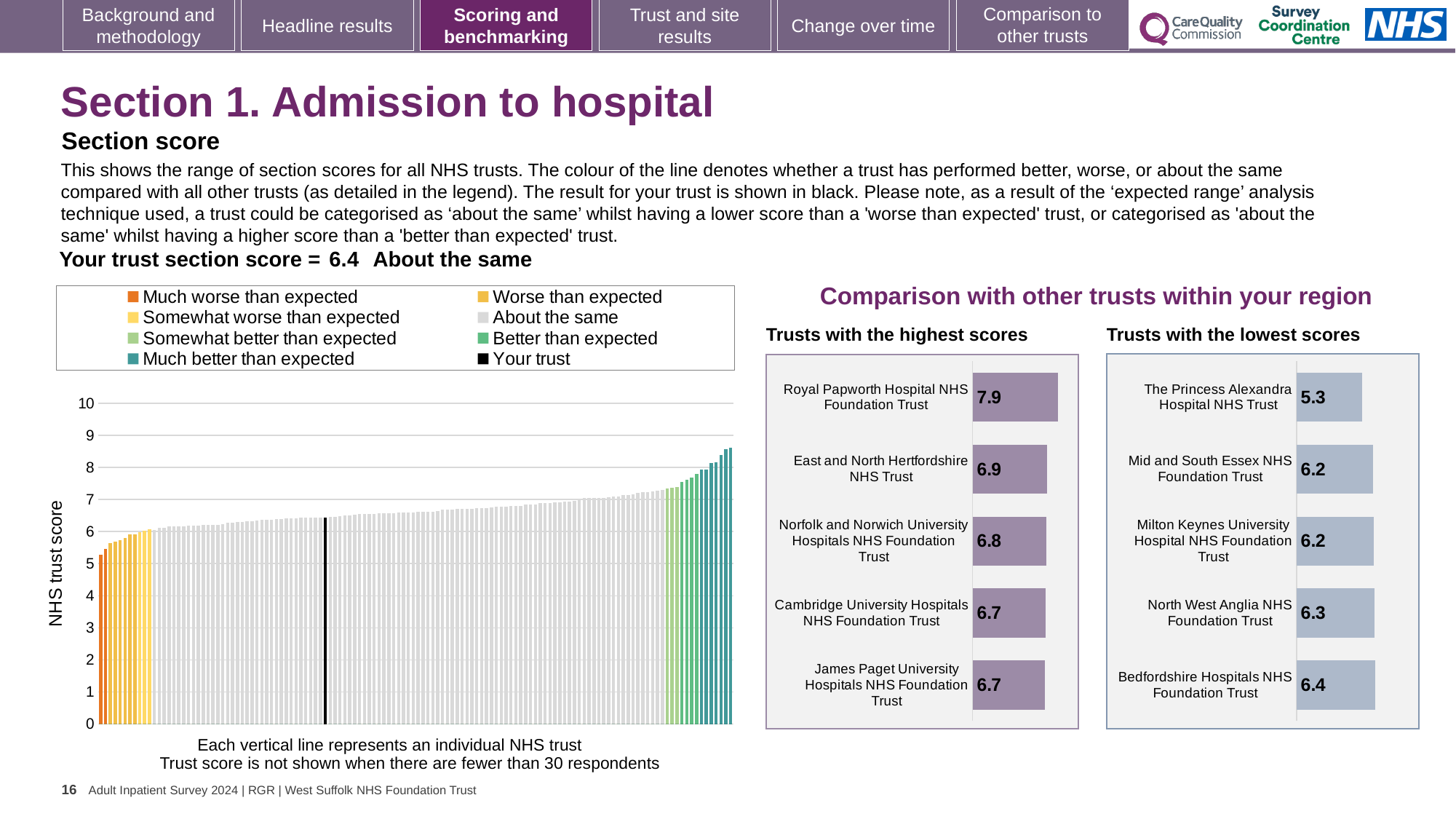
How many entries does the legend of the main NHS trust score chart list? 8 In the 'Trusts with the highest scores' chart, what is the score for Royal Papworth Hospital NHS Foundation Trust? 7.9 In the 'Trusts with the lowest scores' chart, what is the score for The Princess Alexandra Hospital NHS Trust? 5.3 In the 'Trusts with the lowest scores' chart, what is the difference between the scores of Bedfordshire Hospitals NHS Foundation Trust and The Princess Alexandra Hospital NHS Trust? 1.1 In the main NHS trust score chart, do the values rise or fall from left to right? Rise How many trusts are listed in the 'Trusts with the highest scores' chart? 5 In the 'Trusts with the highest scores' chart, which trust has the highest score? Royal Papworth Hospital NHS Foundation Trust In the main NHS trust score chart, is the value of the tallest bar on the far right greater or less than 8? greater In the 'Trusts with the lowest scores' chart, which trust has the lowest score? The Princess Alexandra Hospital NHS Trust In the 'Trusts with the highest scores' chart, what is the difference between the scores of Royal Papworth Hospital NHS Foundation Trust and East and North Hertfordshire NHS Trust? 1.0 Which is larger: the score for Norfolk and Norwich University Hospitals NHS Foundation Trust in the highest scores chart, or the score for North West Anglia NHS Foundation Trust in the lowest scores chart? Norfolk and Norwich University Hospitals NHS Foundation Trust What kind of chart is the main chart showing NHS trust scores on the left of the slide? Bar chart